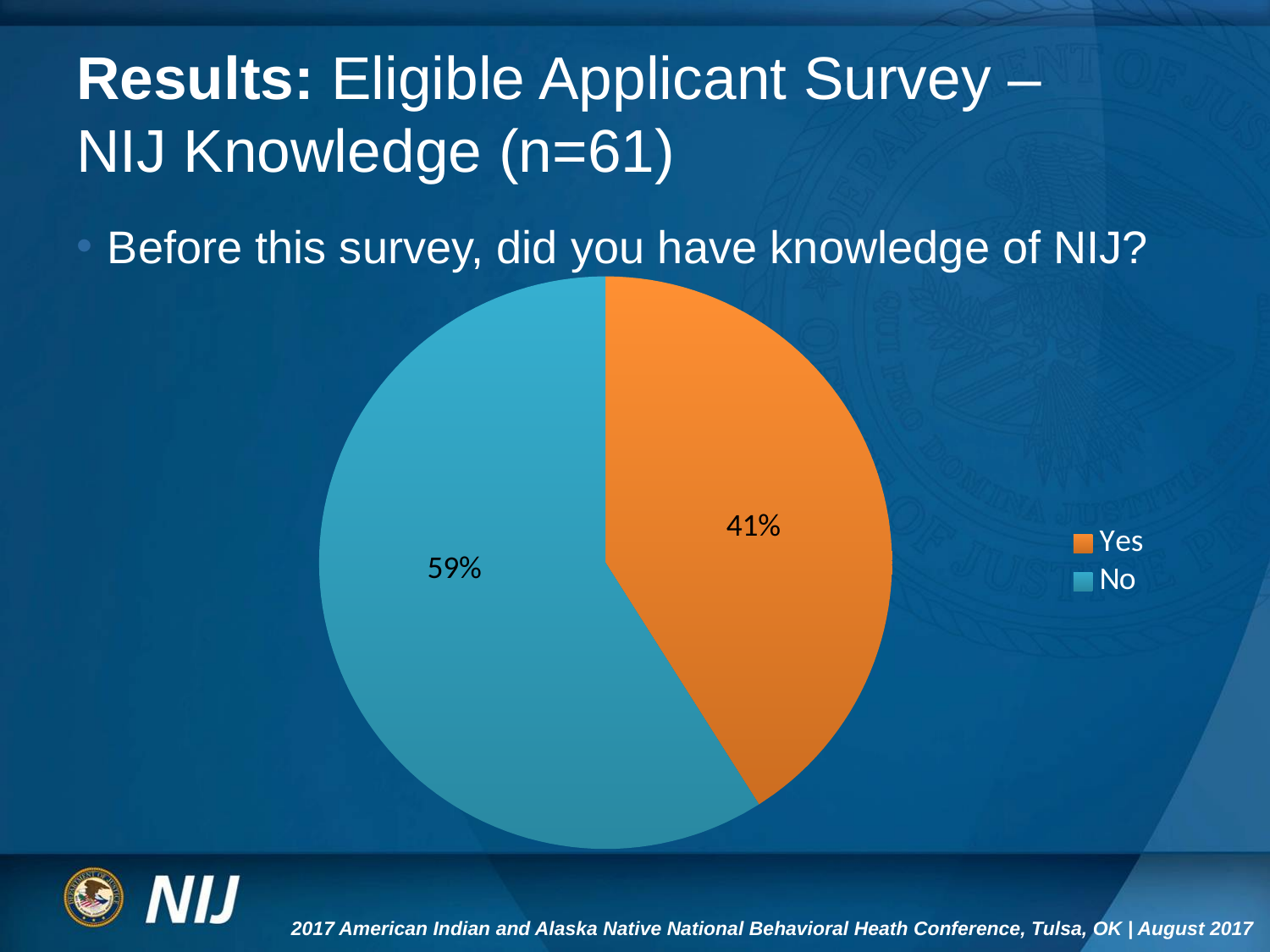
Which response has the largest share of the pie? No What percentage of respondents answered No? 59% What kind of chart is shown on the slide? pie chart What is the difference in percentage points between the No and Yes slices? 18 What colour is the No slice? blue How many slices does the pie chart have? 2 Which response has the smallest share of the pie? Yes How many entries does the legend list? 2 What colour is the Yes slice? orange Which slice is larger, Yes or No? No What percentage of respondents answered Yes? 41% What share of the pie does the No slice represent? 59%